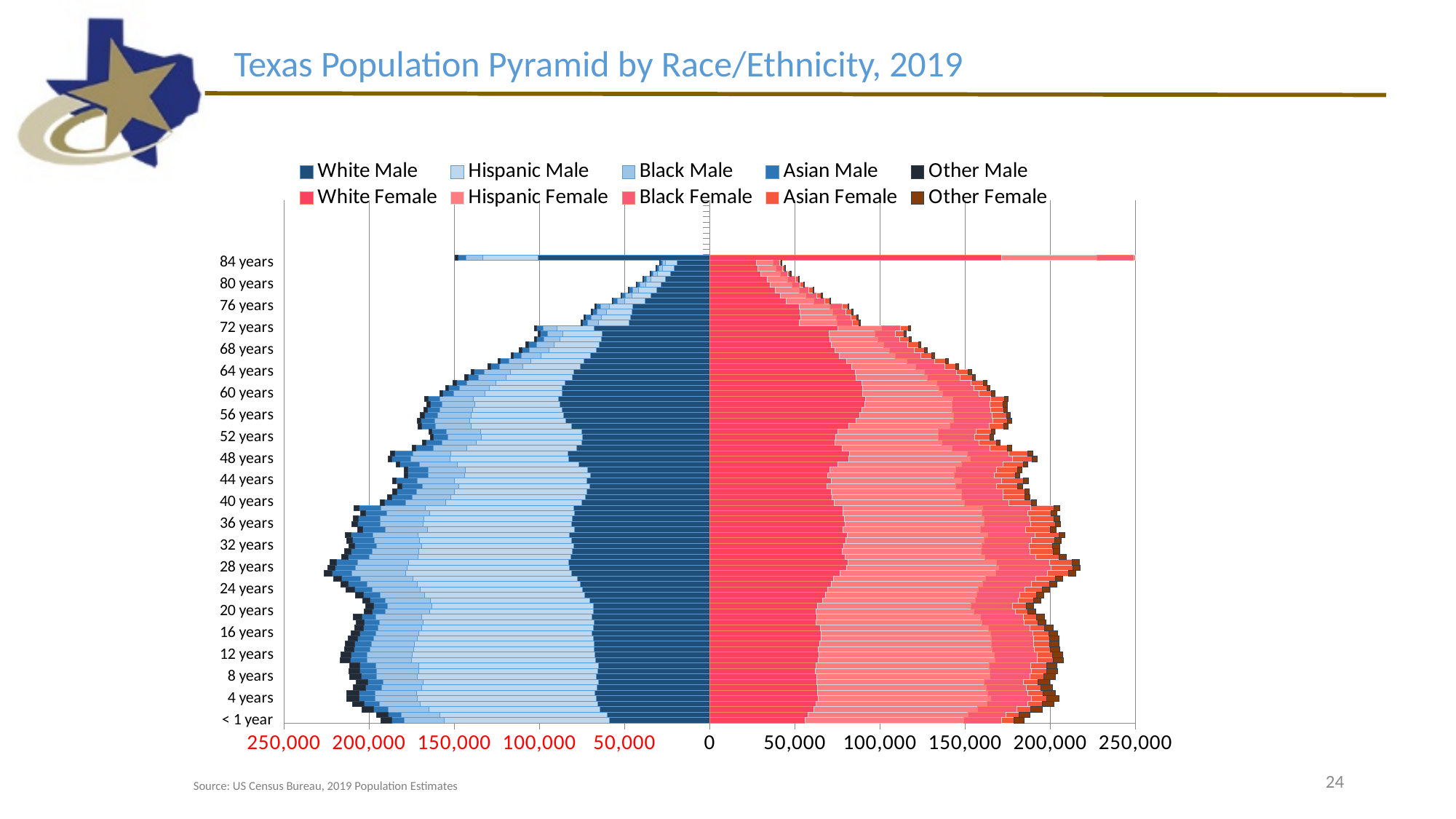
What is the title of the chart? Texas Population Pyramid by Race/Ethnicity, 2019 Is the total male population for the 28 years bar greater or less than 200,000? greater Moving from 80 years down to 60 years, do the total male bars get longer or shorter? longer What kind of chart is shown on the slide? Bar chart (population pyramid) Which is larger, the total female bar at 28 years or the total female bar at 80 years? 28 years Is the total male population for the 60 years bar greater or less than 150,000? greater How many age labels are shown on the vertical axis? 22 Is the total female population for the 68 years bar greater or less than 150,000? less How many series does the legend list? 10 Which series is listed first in the legend? White Male